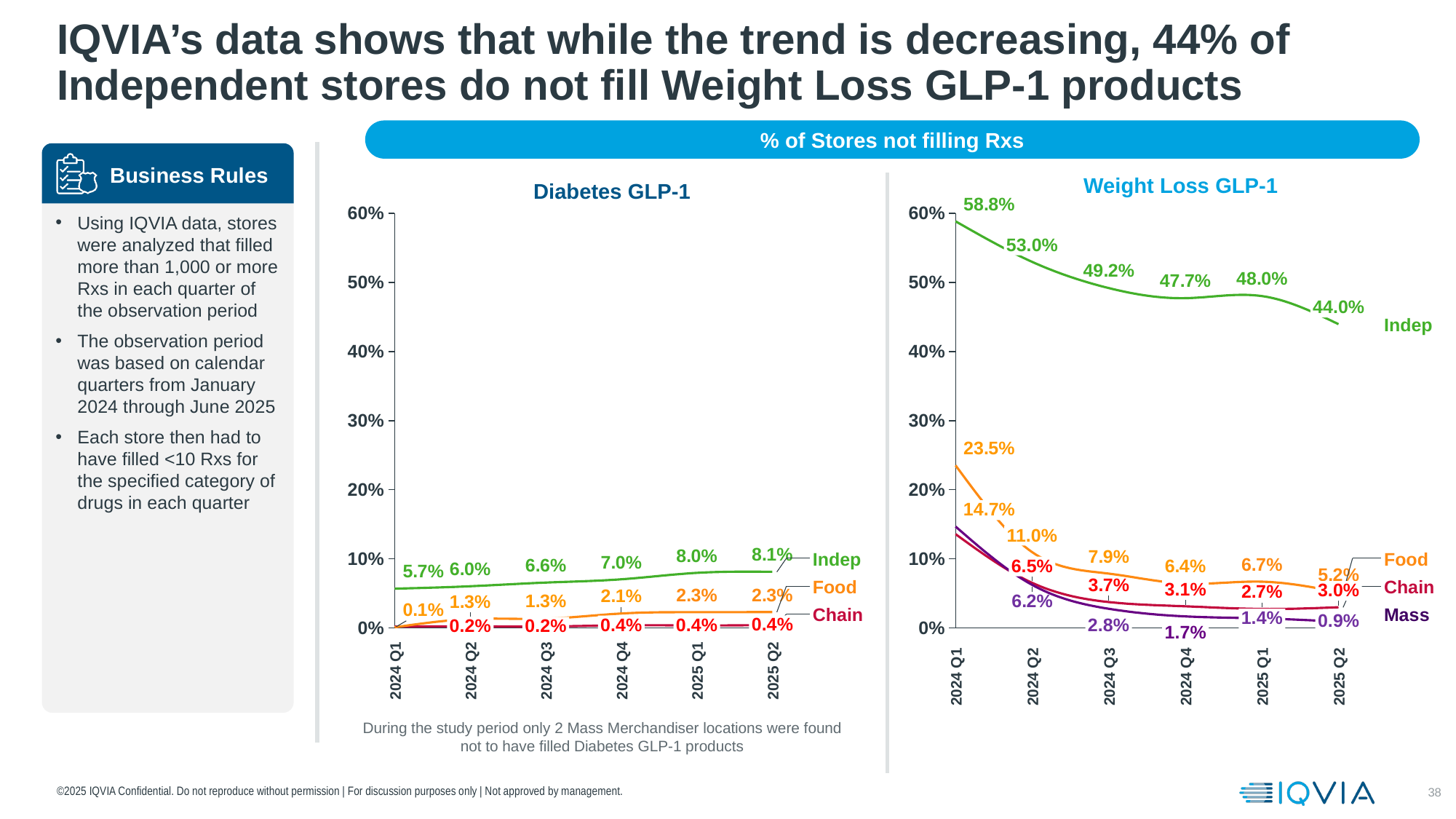
In the Diabetes GLP-1 chart, which is larger in 2025 Q2: Indep or Food? Indep How many quarters are shown on the x axis of the Diabetes GLP-1 chart? 6 In the Weight Loss GLP-1 chart, what is the value for Mass in 2025 Q2? 0.9% In the Weight Loss GLP-1 chart, is the Indep value in 2024 Q3 greater or less than 50%? less In the Weight Loss GLP-1 chart, in which quarter is the Chain value lowest? 2025 Q1 What type of chart is the Diabetes GLP-1 chart? Line chart In the Diabetes GLP-1 chart, what is the value for Indep in 2024 Q1? 5.7% How many series are plotted in the Weight Loss GLP-1 chart? 4 In the Weight Loss GLP-1 chart, what is the difference between the Indep values in 2024 Q1 and 2025 Q2? 14.8% In the Weight Loss GLP-1 chart, in which quarter is the Indep value highest? 2024 Q1 In the Diabetes GLP-1 chart, what is the value for Food in 2024 Q4? 2.1% In the Weight Loss GLP-1 chart, what is the value for Indep in 2025 Q2? 44.0%